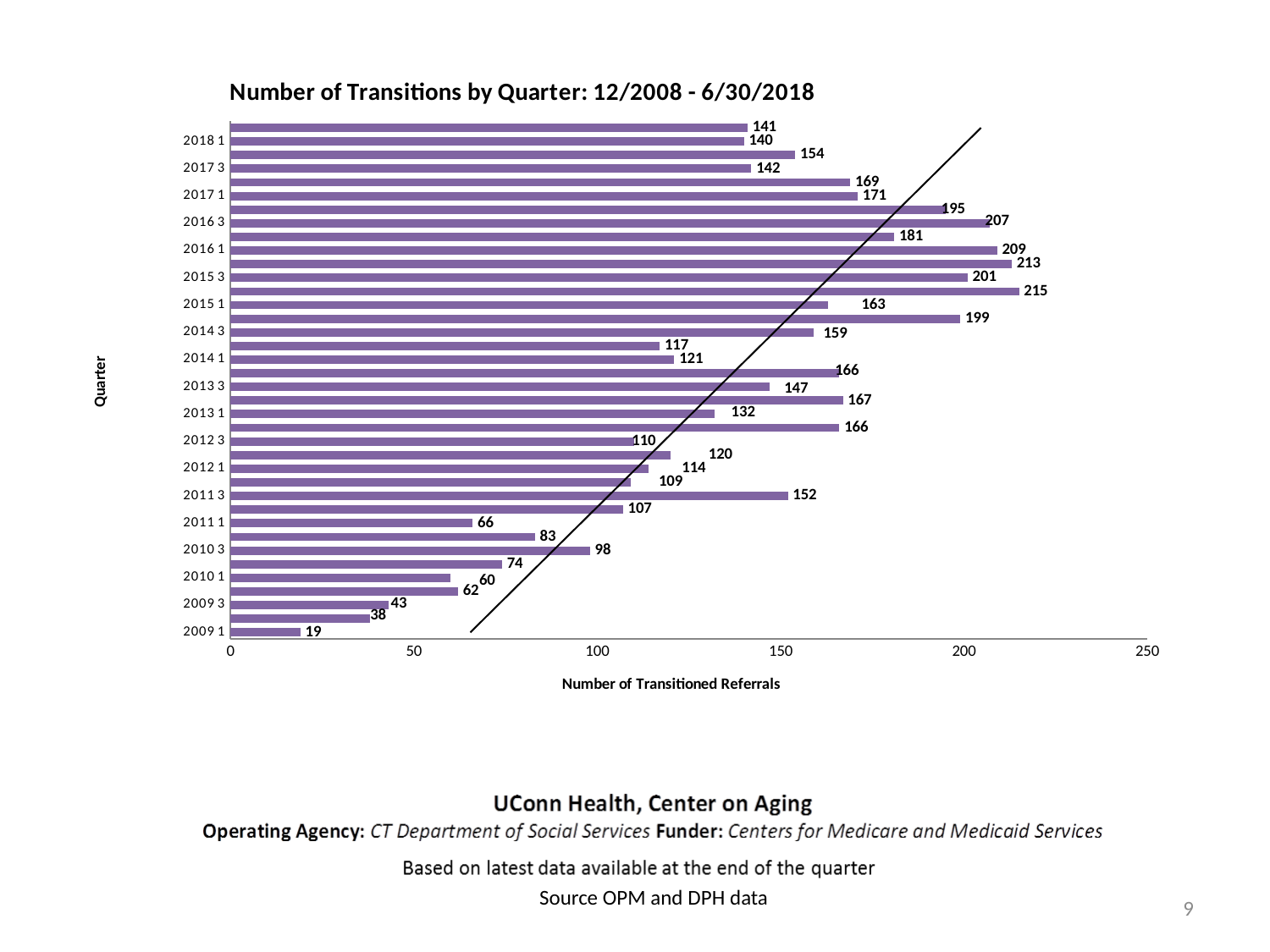
What is the number of transitioned referrals for quarter 2013 1? 132 What is the title of the horizontal axis? Number of Transitioned Referrals What is the highest number of transitioned referrals shown on the chart? 215 Is the value for quarter 2014 3 greater or less than 150? greater What is the number of transitioned referrals for quarter 2017 3? 142 Which quarter has a larger value, 2015 3 or 2017 1? 2015 3 Which quarter has the lowest number of transitioned referrals? 2009 1 How many bars are plotted on the chart? 38 What kind of chart is shown on the slide? bar chart What is the difference between the values for quarter 2011 3 and quarter 2011 1? 86 What is the number of transitioned referrals for quarter 2016 1? 209 What is the number of transitioned referrals for quarter 2009 1? 19